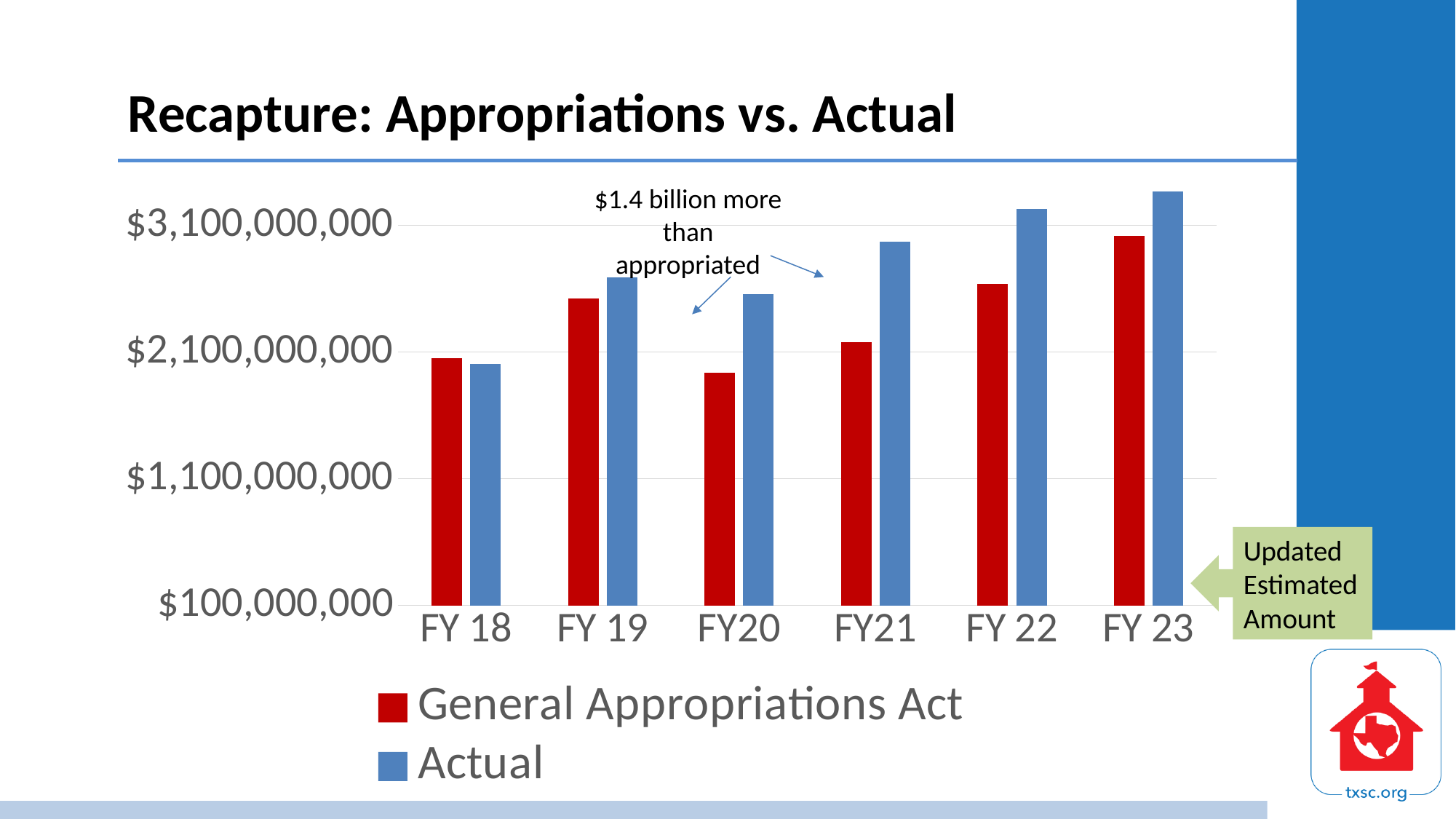
Which fiscal year has the lowest Actual value? FY 18 What kind of chart is shown on the slide? bar chart Is the Actual value for FY 23 greater or less than $3,100,000,000? greater Which fiscal year has the lowest General Appropriations Act value? FY20 Which colour represents the Actual series in the legend? blue Do the Actual values generally rise or fall from FY 18 to FY 23? rise In FY20, which is larger: the General Appropriations Act value or the Actual value? Actual Is the General Appropriations Act value for FY20 greater or less than $2,100,000,000? less Is the Actual value for FY 18 greater or less than $2,100,000,000? less Which fiscal year has the highest Actual value? FY 23 How many fiscal years are shown on the x axis? 6 How many series does the legend list? 2